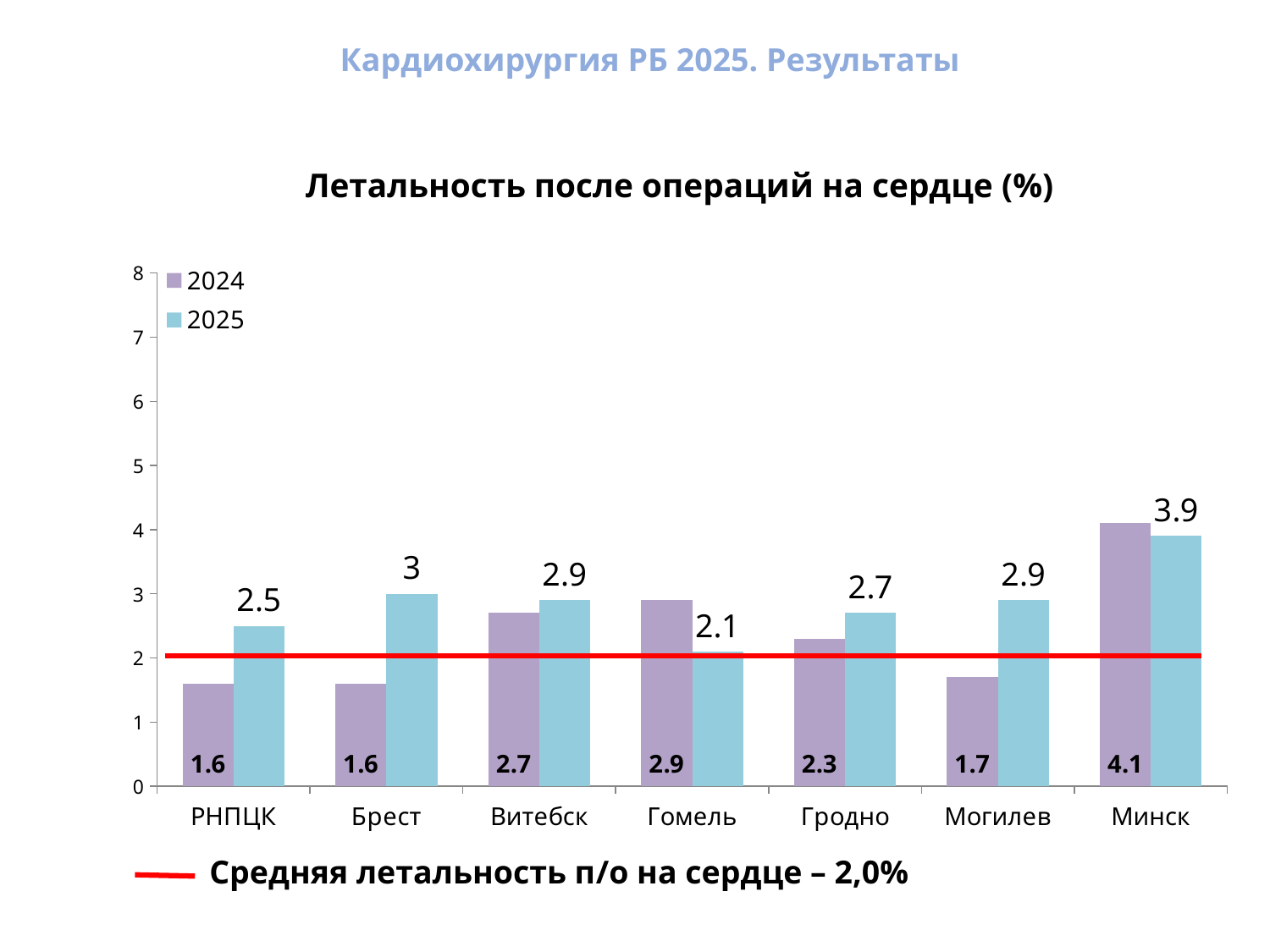
What value does the red horizontal line represent, according to the caption below the chart? 2,0% Is the 2024 value for Гродно greater or less than 2? greater What kind of chart is shown on the slide? bar chart How many categories are shown on the x axis? 7 Which category has the highest 2024 value? Минск What is the 2025 value for Гомель? 2.1 Which is larger for Гомель: the 2024 value or the 2025 value? 2024 How many series does the legend list? 2 Which category has the lowest 2025 value? Гомель What is the 2025 value for Брест? 3 What is the 2024 value for Минск? 4.1 What is the difference between the 2025 and 2024 values for Могилев? 1.2